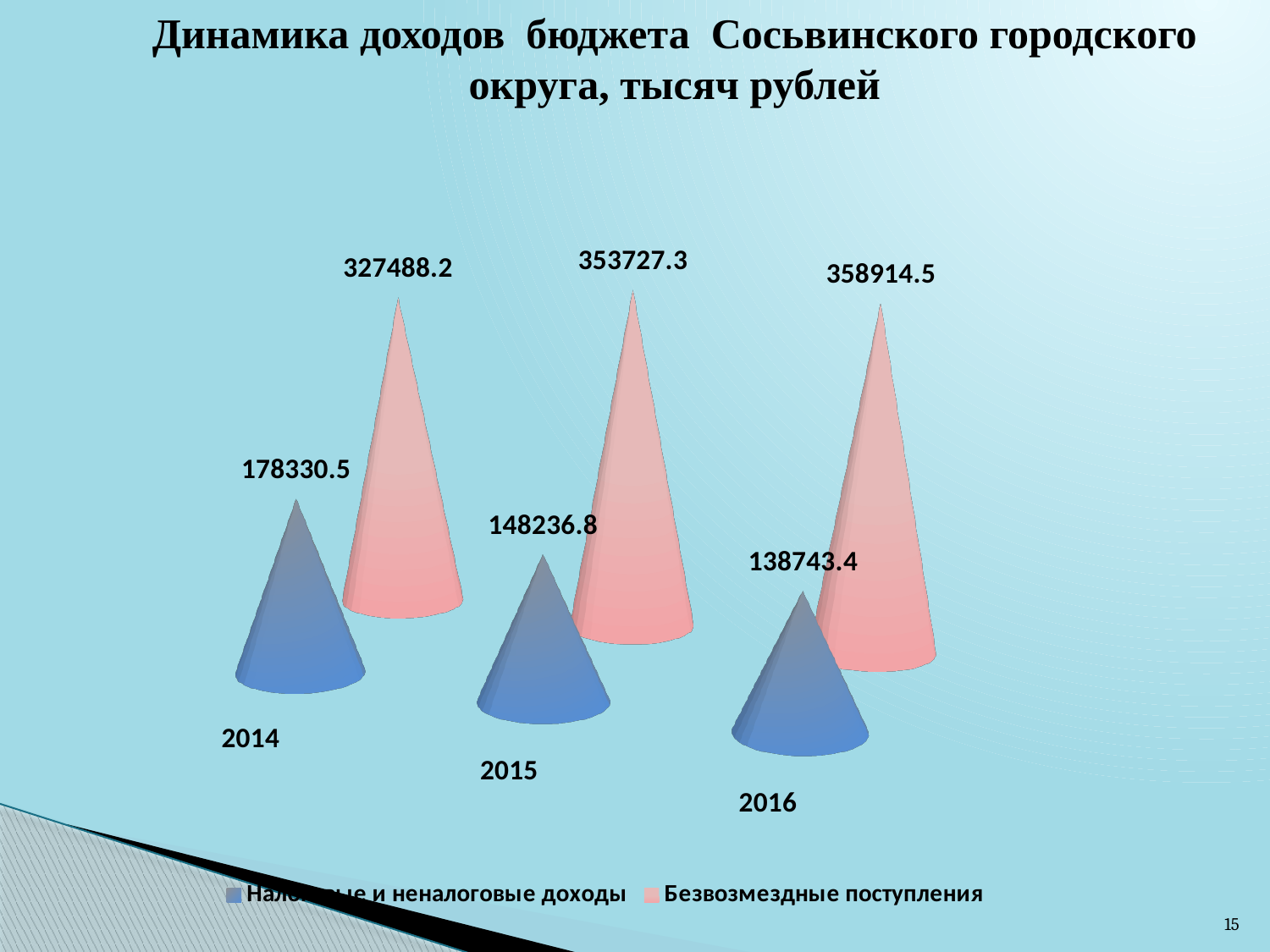
How many years are shown on the chart? 3 Which is larger: Налоговые и неналоговые доходы in 2015 or in 2016? 2015 What is the value of Безвозмездные поступления for 2016? 358914.5 In which year is Безвозмездные поступления the highest? 2016 What is the difference between Безвозмездные поступления and Налоговые и неналоговые доходы in 2014? 149157.7 What is the total of Налоговые и неналоговые доходы and Безвозмездные поступления for 2016? 497657.9 How many series does the legend list? 2 What is the value of Безвозмездные поступления for 2015? 353727.3 What is the value of Налоговые и неналоговые доходы for 2014? 178330.5 What kind of chart is shown on the slide? bar chart Do the values for Налоговые и неналоговые доходы rise or fall from 2014 to 2016? fall In which year is Налоговые и неналоговые доходы the lowest? 2016